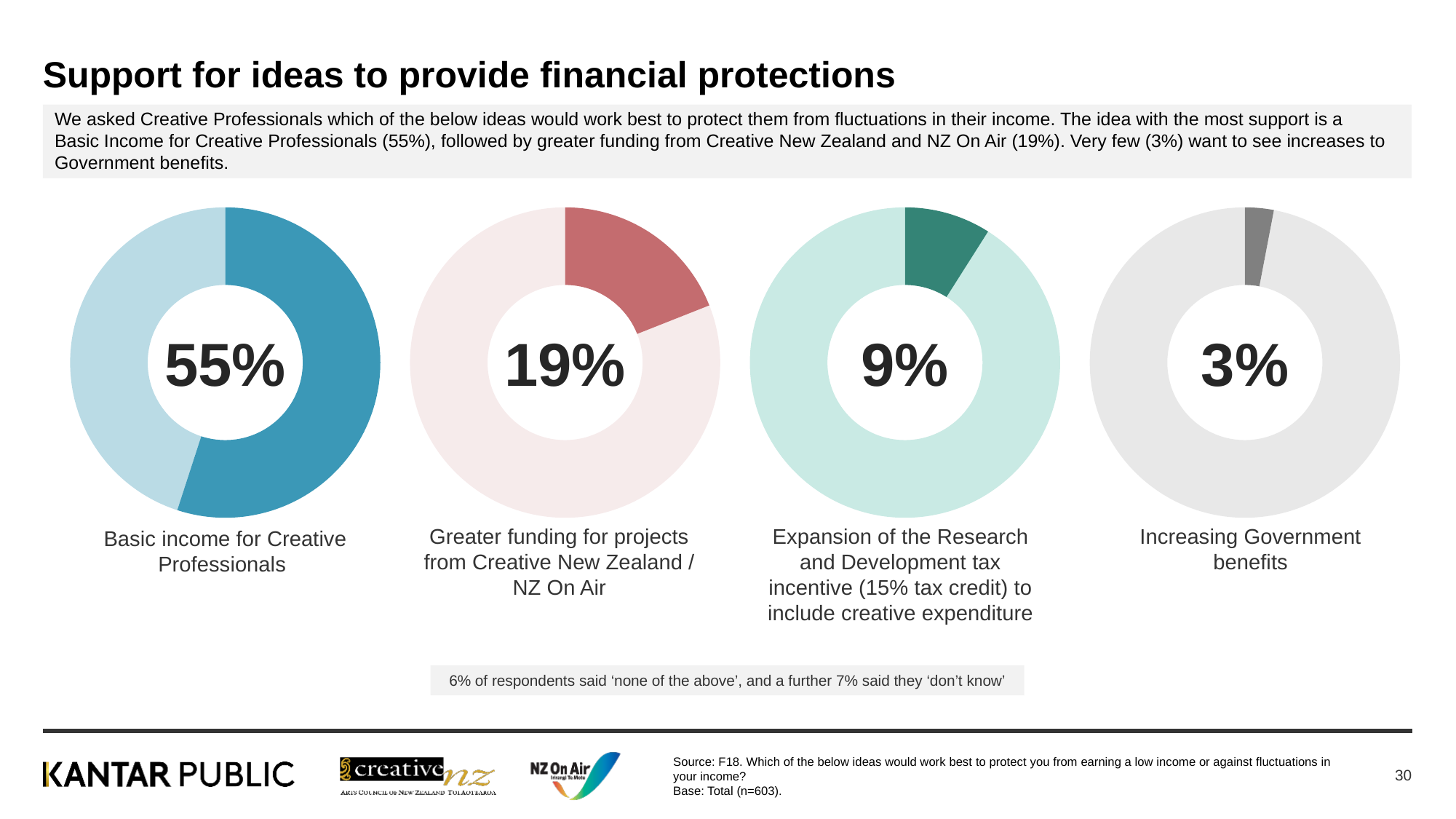
What is the difference in support between basic income for Creative Professionals and greater funding from Creative New Zealand / NZ On Air? 36 percentage points What percentage support greater funding for projects from Creative New Zealand / NZ On Air? 19% What is the difference in support between the R&D tax incentive expansion and increasing Government benefits? 6 percentage points Which idea has the highest level of support? Basic income for Creative Professionals What percentage of Creative Professionals support a basic income for Creative Professionals? 55% Which has more support: greater funding from Creative New Zealand / NZ On Air or expansion of the R&D tax incentive? Greater funding from Creative New Zealand / NZ On Air Which idea has the lowest level of support? Increasing Government benefits What kind of chart is used to show support for each idea? Donut (pie) chart How many ideas are shown as donut charts on the slide? 4 What percentage support increasing Government benefits? 3% What percentage support expansion of the Research and Development tax incentive to include creative expenditure? 9% What colour is the highlighted segment in the donut chart for greater funding from Creative New Zealand / NZ On Air? Red